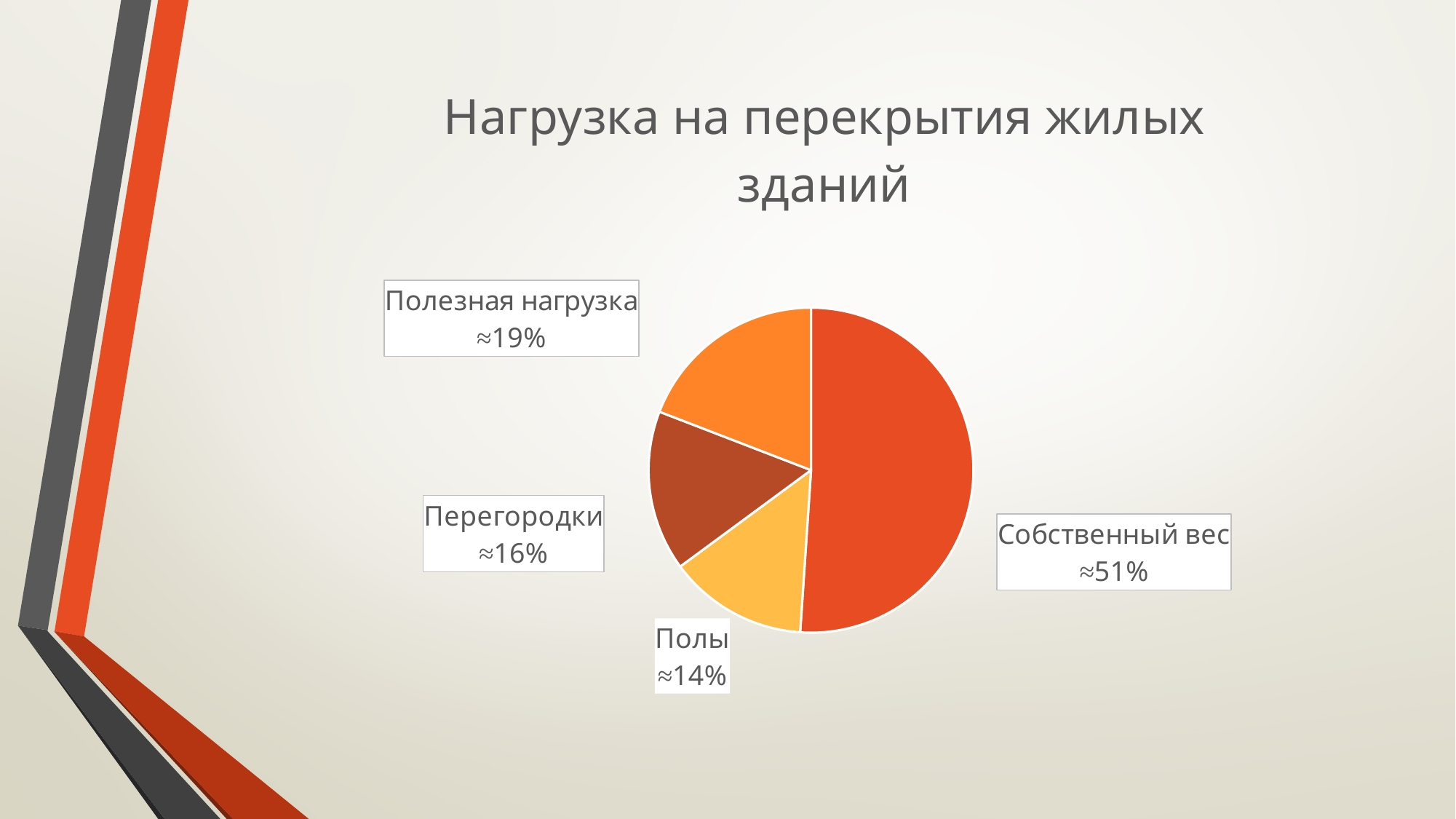
What is the title of the chart? Нагрузка на перекрытия жилых зданий How many slices does the pie chart have? 4 Which category's slice is coloured dark brown? Перегородки What share of the pie is labelled for Полезная нагрузка? ≈19% What kind of chart is shown on the slide? pie chart Which slice is larger, Полезная нагрузка or Перегородки? Полезная нагрузка Which category has the largest slice of the pie? Собственный вес What share of the pie is labelled for Полы? ≈14% Which category has the smallest slice of the pie? Полы What share of the pie is labelled for Собственный вес? ≈51% Which slice is larger, Перегородки or Полы? Перегородки What share of the pie is labelled for Перегородки? ≈16%